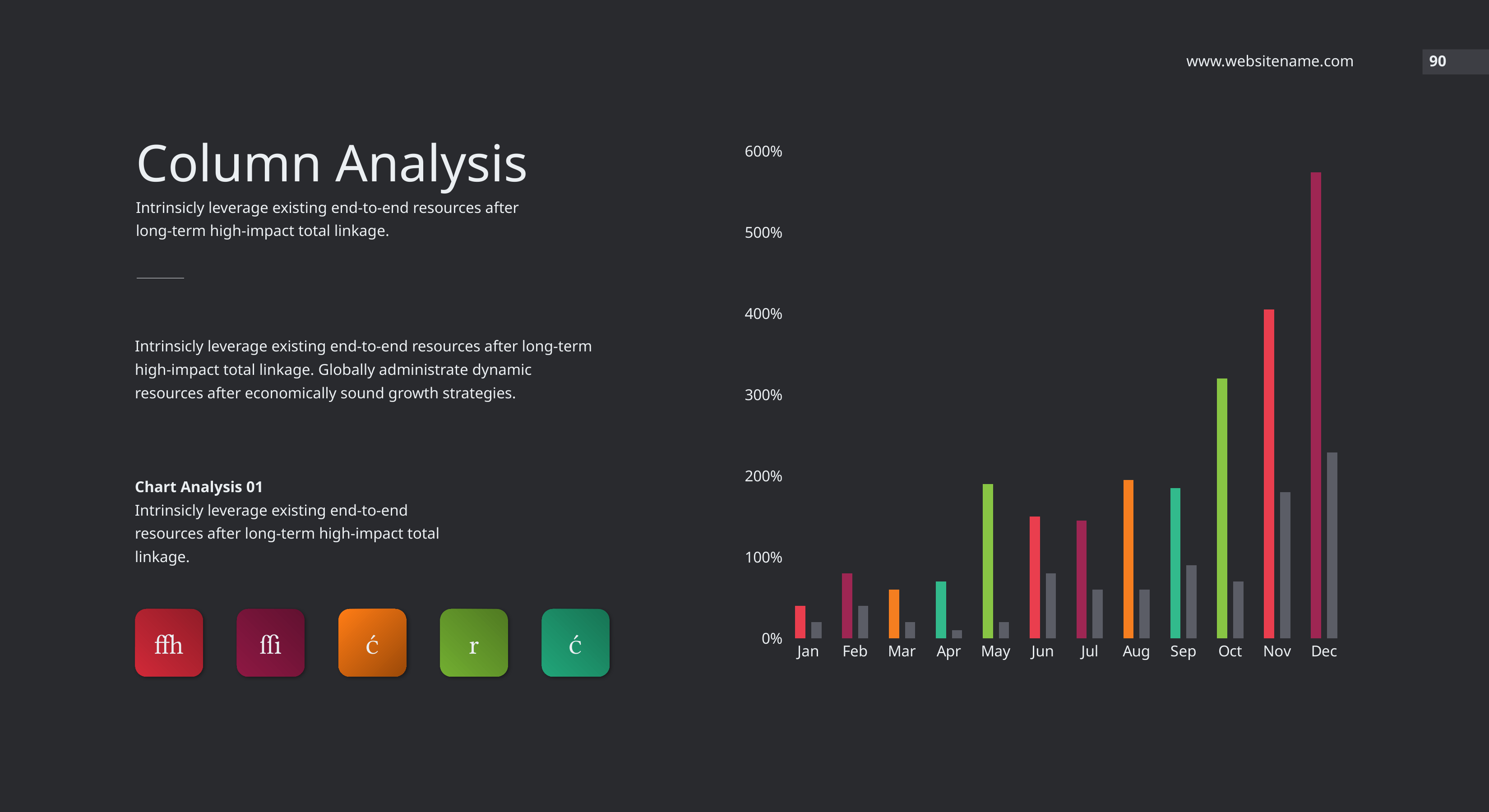
Is the coloured bar for Jan greater or less than 100%? less Which has the taller coloured bar, Apr or May? May Is the coloured bar for Dec greater or less than 500%? greater Which month has the tallest coloured bar in the chart? Dec Do the coloured bars generally rise or fall from Jan to Dec? rise How many months are shown on the x axis of the chart? 12 Is the grey bar for Dec greater or less than 200%? greater Which month has the shortest coloured bar in the chart? Jan What kind of chart is shown on the slide? bar chart Which has the taller coloured bar, Oct or Nov? Nov